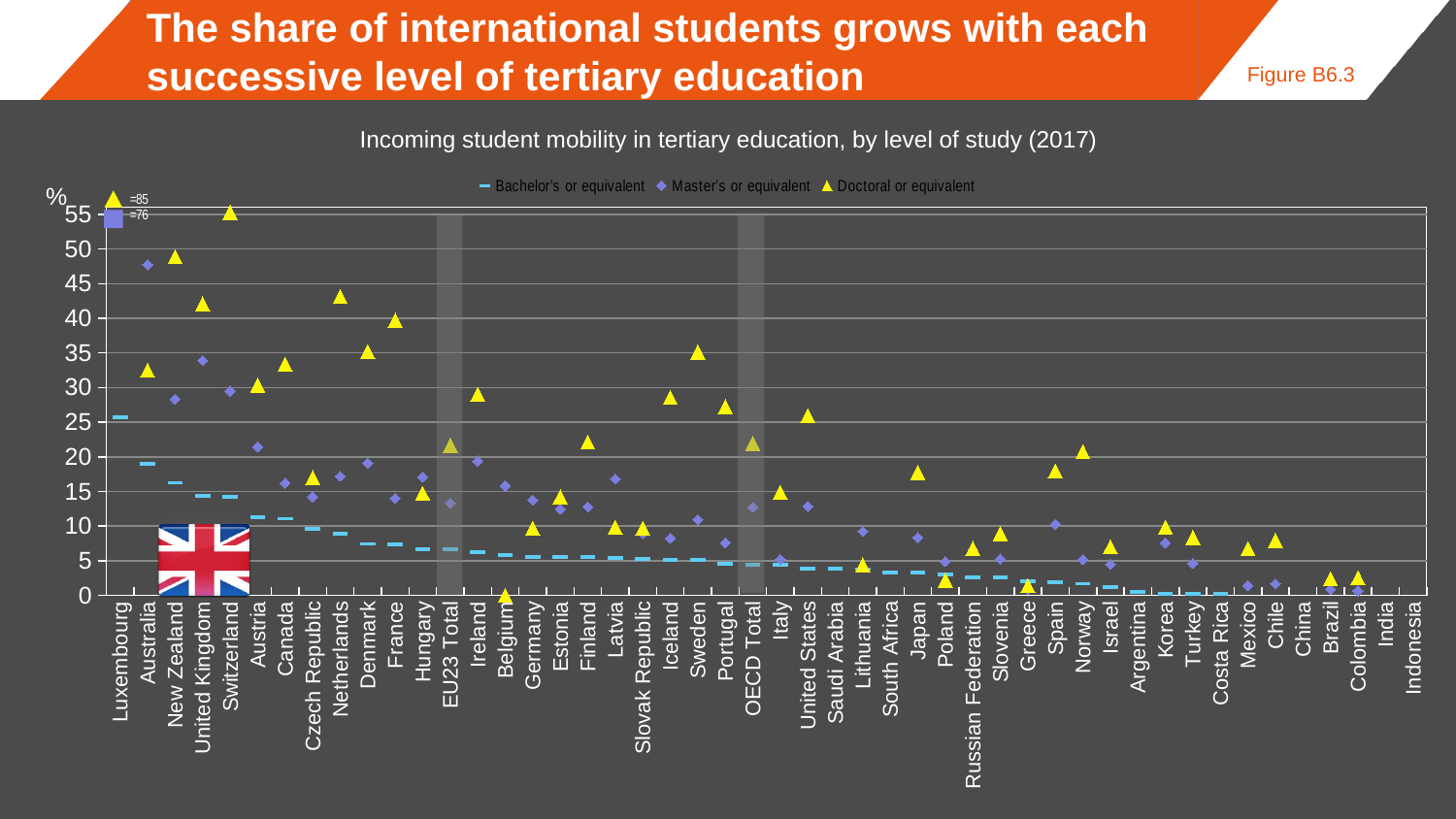
How many series does the legend list? 3 Which country has the highest Master's or equivalent value? Luxembourg Which marker shape represents the Doctoral or equivalent series in the legend? Yellow triangle Is the Doctoral or equivalent value for Netherlands greater or less than 40? greater Which has the larger Doctoral or equivalent value, Switzerland or Austria? Switzerland What is the Doctoral or equivalent value for Luxembourg? 85 Which country has the highest Doctoral or equivalent value? Luxembourg Which has the larger Doctoral or equivalent value, Netherlands or Denmark? Netherlands Do the Doctoral or equivalent values generally rise or fall moving from left to right along the x axis? fall Is the Doctoral or equivalent value for Switzerland greater or less than 50? greater What is the Master's or equivalent value for Luxembourg? 76